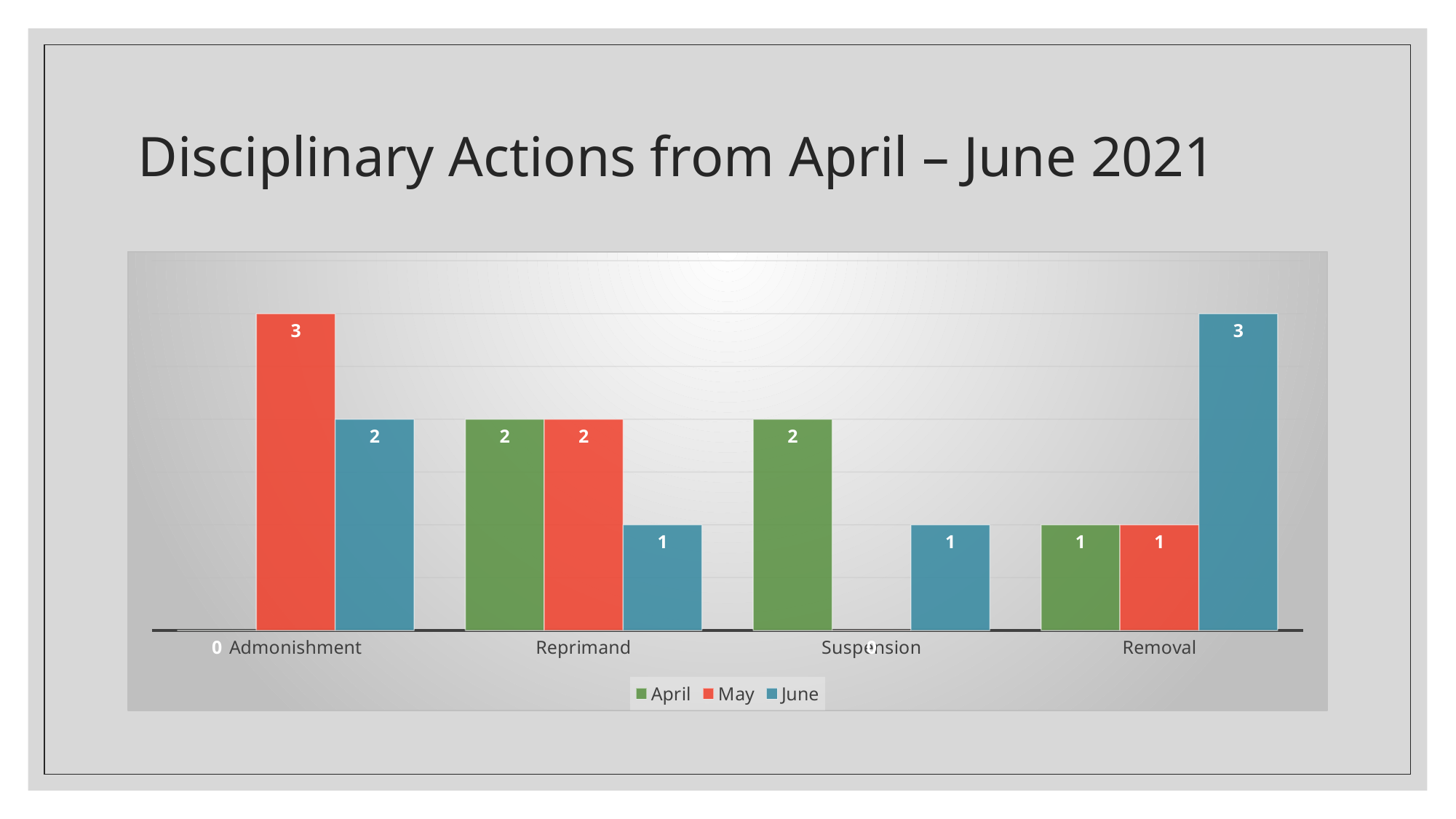
Which category has the lowest value for May? Suspension What kind of chart is shown on the slide? Bar chart Which is larger, the April value for Reprimand or the April value for Removal? Reprimand What is the value for June in the Reprimand category? 1 What is the value for June in the Removal category? 3 What is the value for April in the Suspension category? 2 What is the value for May in the Admonishment category? 3 Which category has the highest value for June? Removal How many series does the legend list? 3 What is the value for April in the Admonishment category? 0 How many categories are shown on the x axis? 4 What is the difference between the May and June values for Admonishment? 1